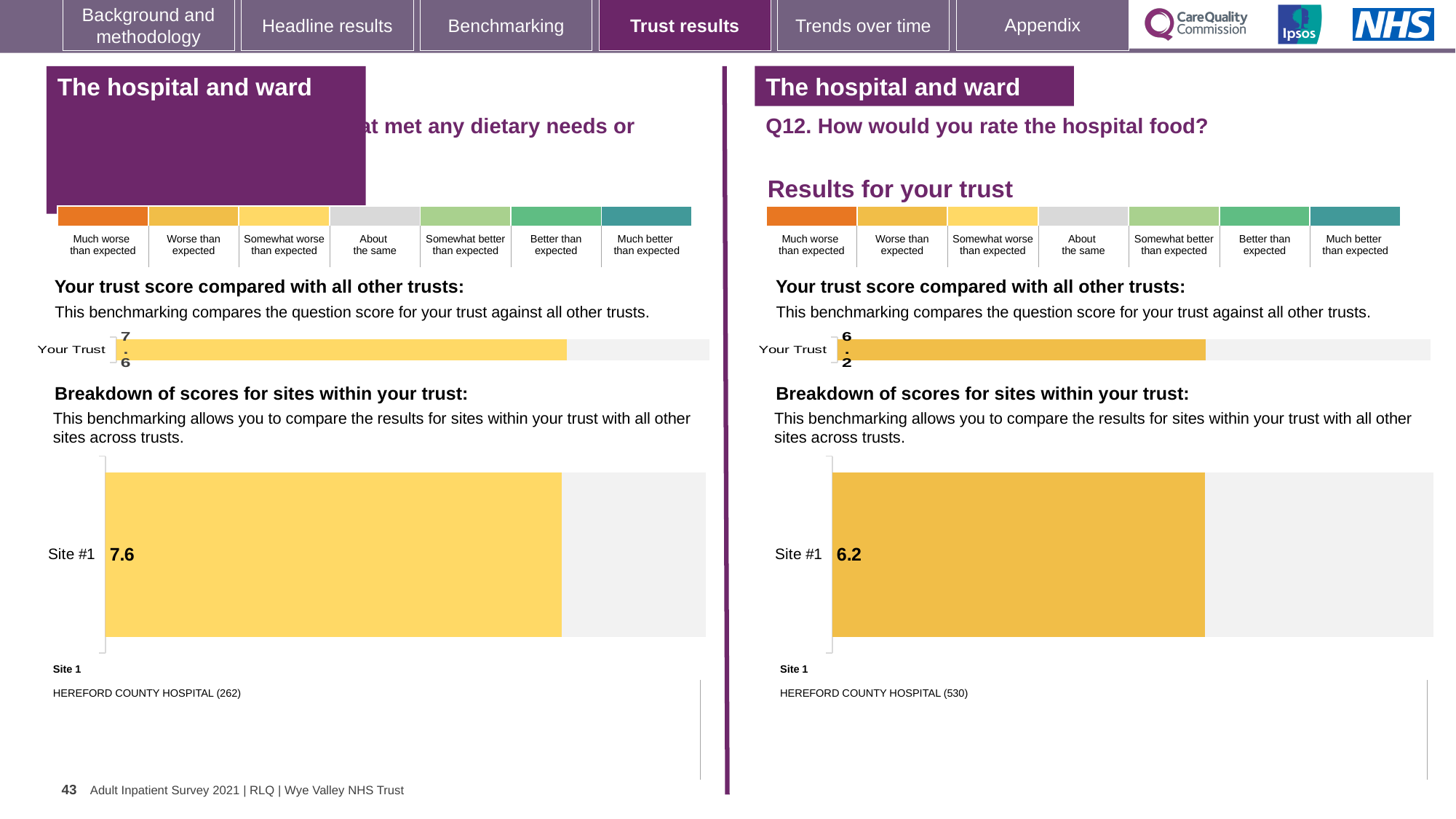
How many sites are shown in the right-hand site breakdown chart for Q12? 1 Which site name is listed as Site 1 beneath the left-hand breakdown chart? HEREFORD COUNTY HOSPITAL (262) What type of chart is used to show the Site #1 score on the right-hand Q12 breakdown? Bar chart Which is larger: the Site #1 score on the left-hand site breakdown chart or the Site #1 score on the right-hand site breakdown chart for Q12? Left-hand chart (7.6) Which site name is listed as Site 1 beneath the right-hand Q12 breakdown chart? HEREFORD COUNTY HOSPITAL (530) On the left-hand 'Your Trust' chart, what score is shown for Your Trust? 7.6 On the right-hand chart for Q12 (How would you rate the hospital food?), what is the score shown for Your Trust? 6.2 What is the difference between the Site #1 score on the left-hand chart (7.6) and the Site #1 score on the right-hand Q12 chart (6.2)? 1.4 On the left-hand site breakdown chart, what is the score for Site #1? 7.6 How many sites are shown in the left-hand site breakdown chart? 1 On the right-hand site breakdown chart for Q12, what is the score for Site #1? 6.2 On the right-hand Q12 chart, is the Your Trust score of 6.2 the same as the Site #1 score? Yes